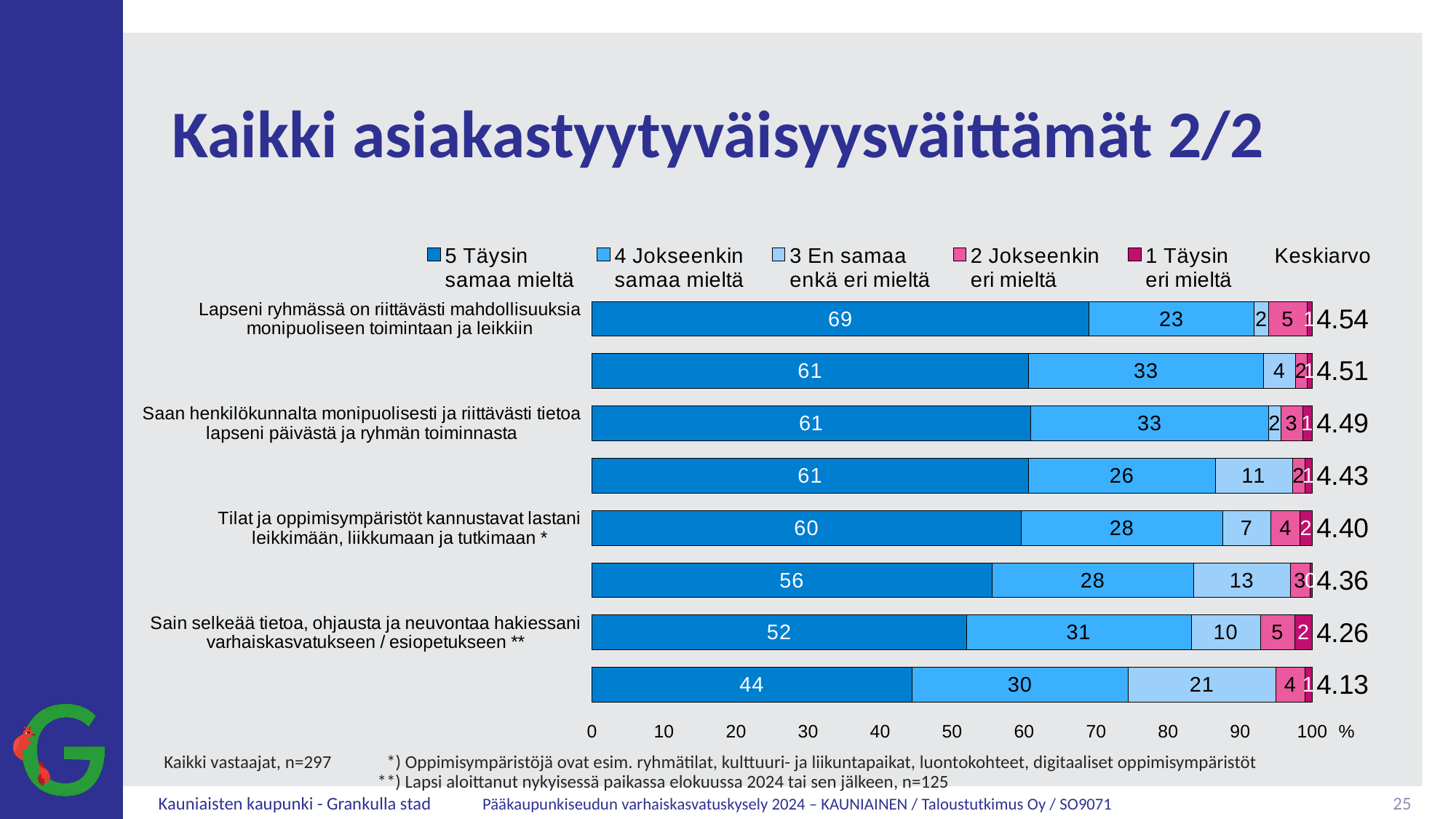
Which statement has the highest Keskiarvo? Lapseni ryhmässä on riittävästi mahdollisuuksia monipuoliseen toimintaan ja leikkiin What is the value of "4 Jokseenkin samaa mieltä" for "Saan henkilökunnalta monipuolisesti ja riittävästi tietoa lapseni päivästä ja ryhmän toiminnasta"? 33 Is the "5 Täysin samaa mieltä" value for "Tilat ja oppimisympäristöt kannustavat lastani leikkimään, liikkumaan ja tutkimaan *" greater or less than 50? greater What is the value of "3 En samaa enkä eri mieltä" for "Sain selkeää tietoa, ohjausta ja neuvontaa hakiessani varhaiskasvatukseen / esiopetukseen **"? 10 How many bars (statements) are plotted in the chart? 8 What is the Keskiarvo for "Tilat ja oppimisympäristöt kannustavat lastani leikkimään, liikkumaan ja tutkimaan *"? 4.40 What kind of chart is shown on the slide? Stacked bar chart What is the title of the slide? Kaikki asiakastyytyväisyysväittämät 2/2 Among the labelled statements, which has the lowest Keskiarvo? Sain selkeää tietoa, ohjausta ja neuvontaa hakiessani varhaiskasvatukseen / esiopetukseen ** What is the value of "5 Täysin samaa mieltä" for "Lapseni ryhmässä on riittävästi mahdollisuuksia monipuoliseen toimintaan ja leikkiin"? 69 What is the difference in "5 Täysin samaa mieltä" between "Lapseni ryhmässä on riittävästi mahdollisuuksia monipuoliseen toimintaan ja leikkiin" and "Sain selkeää tietoa, ohjausta ja neuvontaa hakiessani varhaiskasvatukseen / esiopetukseen **"? 17 Which has a larger "4 Jokseenkin samaa mieltä" value: "Tilat ja oppimisympäristöt kannustavat lastani leikkimään, liikkumaan ja tutkimaan *" or "Sain selkeää tietoa, ohjausta ja neuvontaa hakiessani varhaiskasvatukseen / esiopetukseen **"? Sain selkeää tietoa, ohjausta ja neuvontaa hakiessani varhaiskasvatukseen / esiopetukseen **